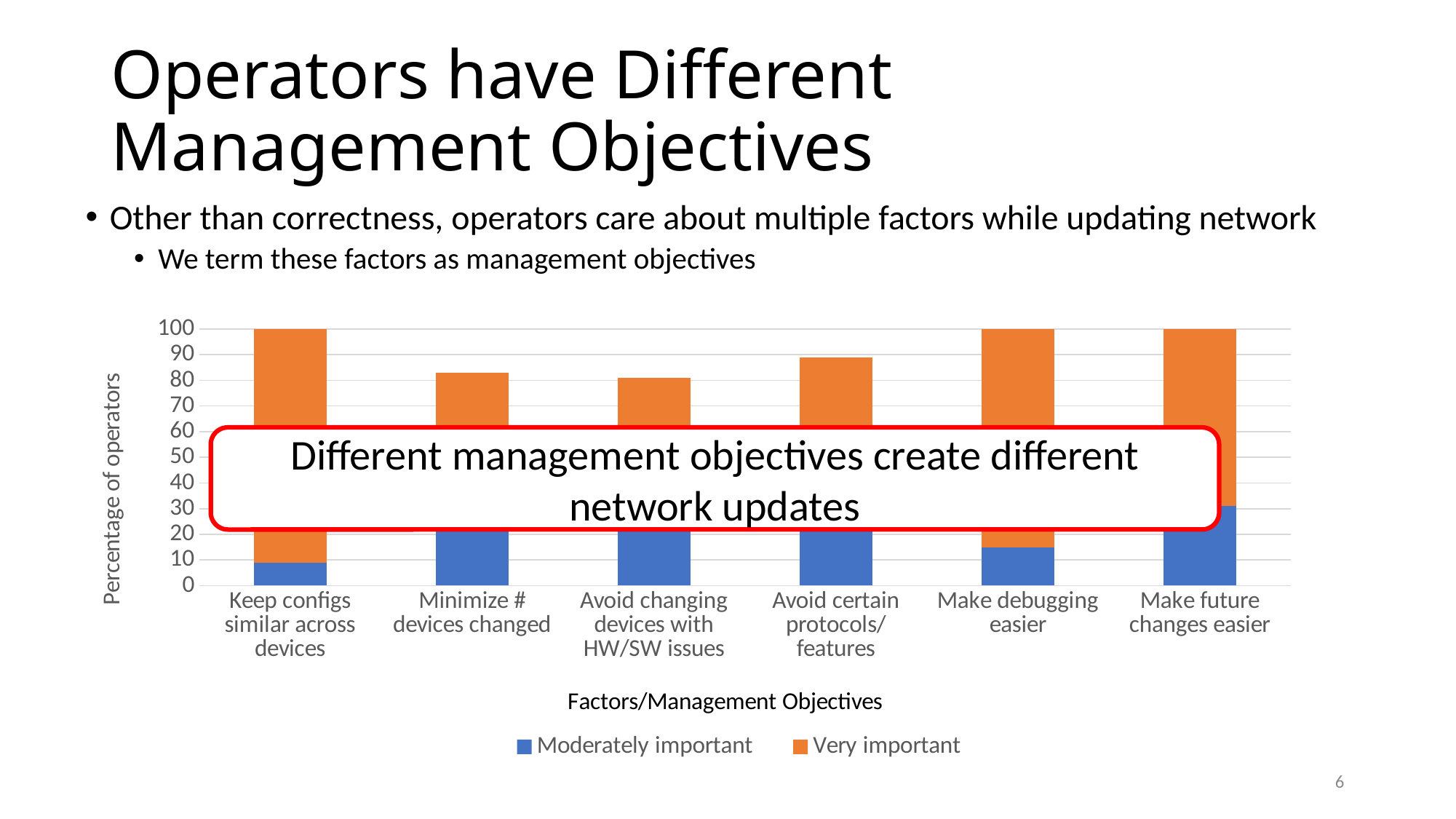
What kind of chart is shown on the slide? Stacked bar chart What are the two series named in the legend? Moderately important and Very important Is the 'Moderately important' value for 'Make debugging easier' greater or less than 20? less Is the total for 'Minimize # devices changed' greater or less than 90? less How many series does the legend list? 2 Is the 'Moderately important' value for 'Make future changes easier' greater or less than 20? greater What is the total height of the stacked bar for 'Keep configs similar across devices'? 100 Which has the larger 'Moderately important' value: 'Keep configs similar across devices' or 'Make future changes easier'? Make future changes easier What is the total height of the stacked bar for 'Make future changes easier'? 100 What is the label of the y axis? Percentage of operators How many factors/management objectives are shown on the x axis? 6